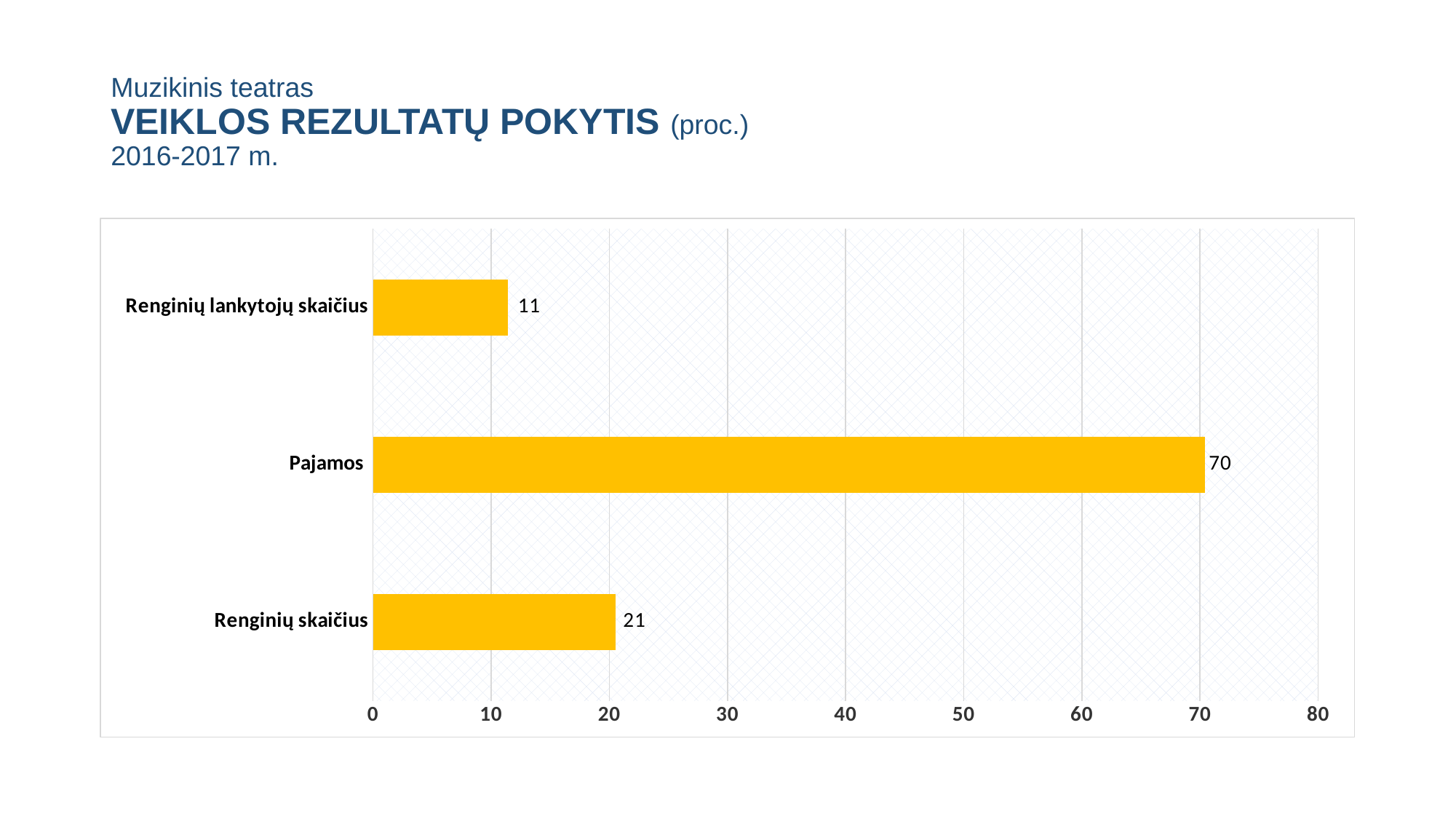
What is the highest value shown on the horizontal axis? 80 Which category has the highest value? Pajamos What kind of chart is shown on the slide? bar chart What is the value for Renginių skaičius? 21 What is the difference between the values for Renginių skaičius and Renginių lankytojų skaičius? 10 Is the value for Pajamos greater or less than 60? greater What is the value for Renginių lankytojų skaičius? 11 Which category has the lowest value? Renginių lankytojų skaičius How many categories are shown in the chart? 3 What is the difference between the values for Pajamos and Renginių skaičius? 49 What is the value for Pajamos? 70 Which is larger, the value for Renginių skaičius or the value for Renginių lankytojų skaičius? Renginių skaičius